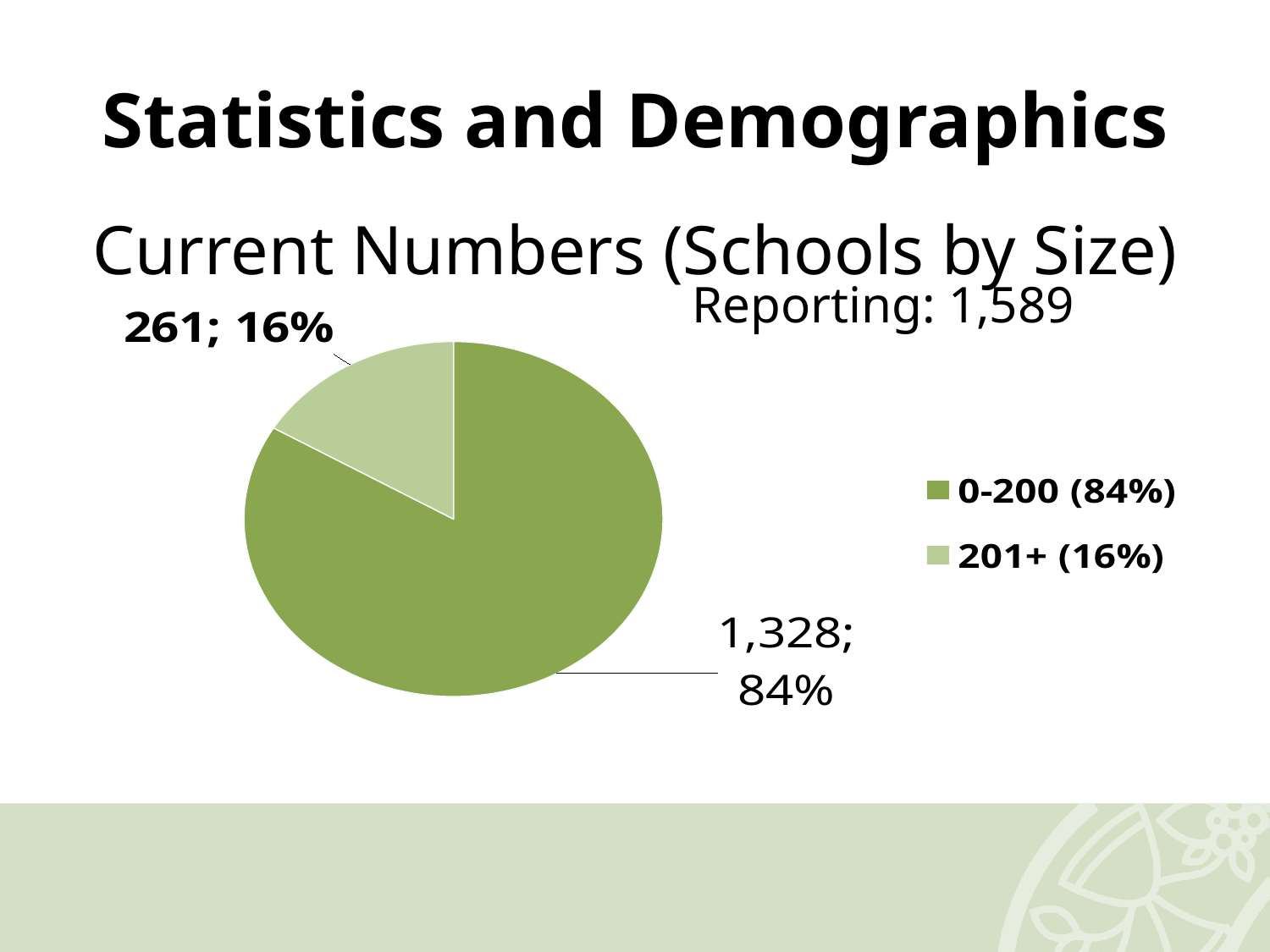
Which category has more schools, 0-200 or 201+? 0-200 Which school size category has the smallest slice? 201+ What kind of chart is shown on the slide? pie chart What is the title of the chart? Current Numbers (Schools by Size) How many schools are in the 0-200 size category? 1,328 What is the difference between the number of schools in the 0-200 category and the 201+ category? 1,067 How many categories does the pie chart show? 2 What is the total number of schools reporting shown on the slide? 1,589 Which school size category has the largest slice? 0-200 What share of the pie does the 0-200 category represent? 84% How many schools are in the 201+ size category? 261 What share of the pie does the 201+ category represent? 16%